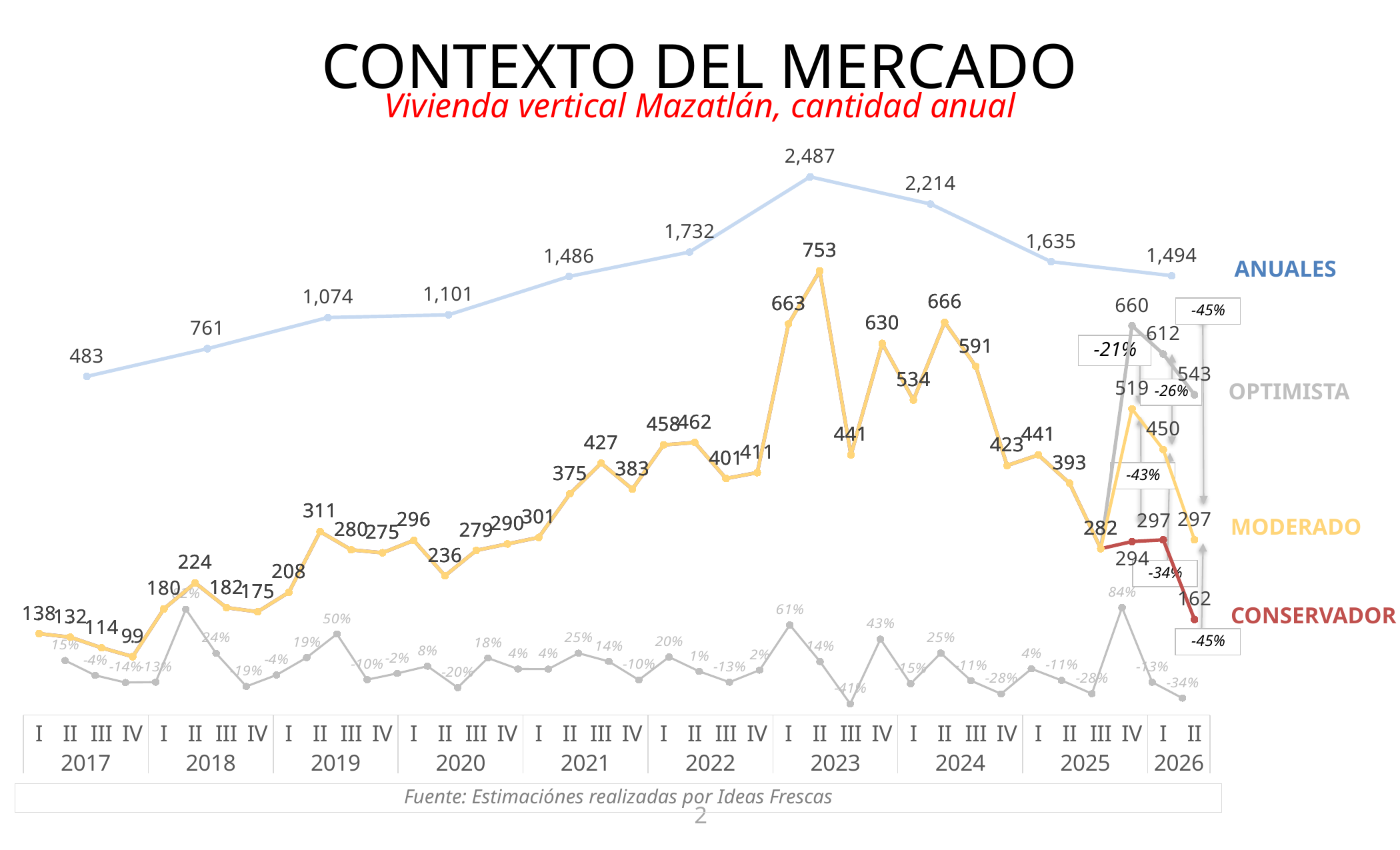
What is the difference between the ANUALES values for 2023 and 2024? 273 What is the highest value shown on the ANUALES line? 2,487 What is the lowest quarterly value on the yellow line, in 2017 IV? 99 What is the value of the ANUALES series for 2017? 483 How many years are labelled on the x axis? 10 Which year has the highest value in the ANUALES series? 2023 What kind of chart is shown on the slide? Line chart Which is larger, the ANUALES value for 2020 or for 2021? 2021 Does the ANUALES series rise or fall from 2017 to 2023? Rise What is the OPTIMISTA value for 2025 IV? 660 What is the CONSERVADOR value for 2026 II? 162 What is the highest quarterly value on the yellow line? 753